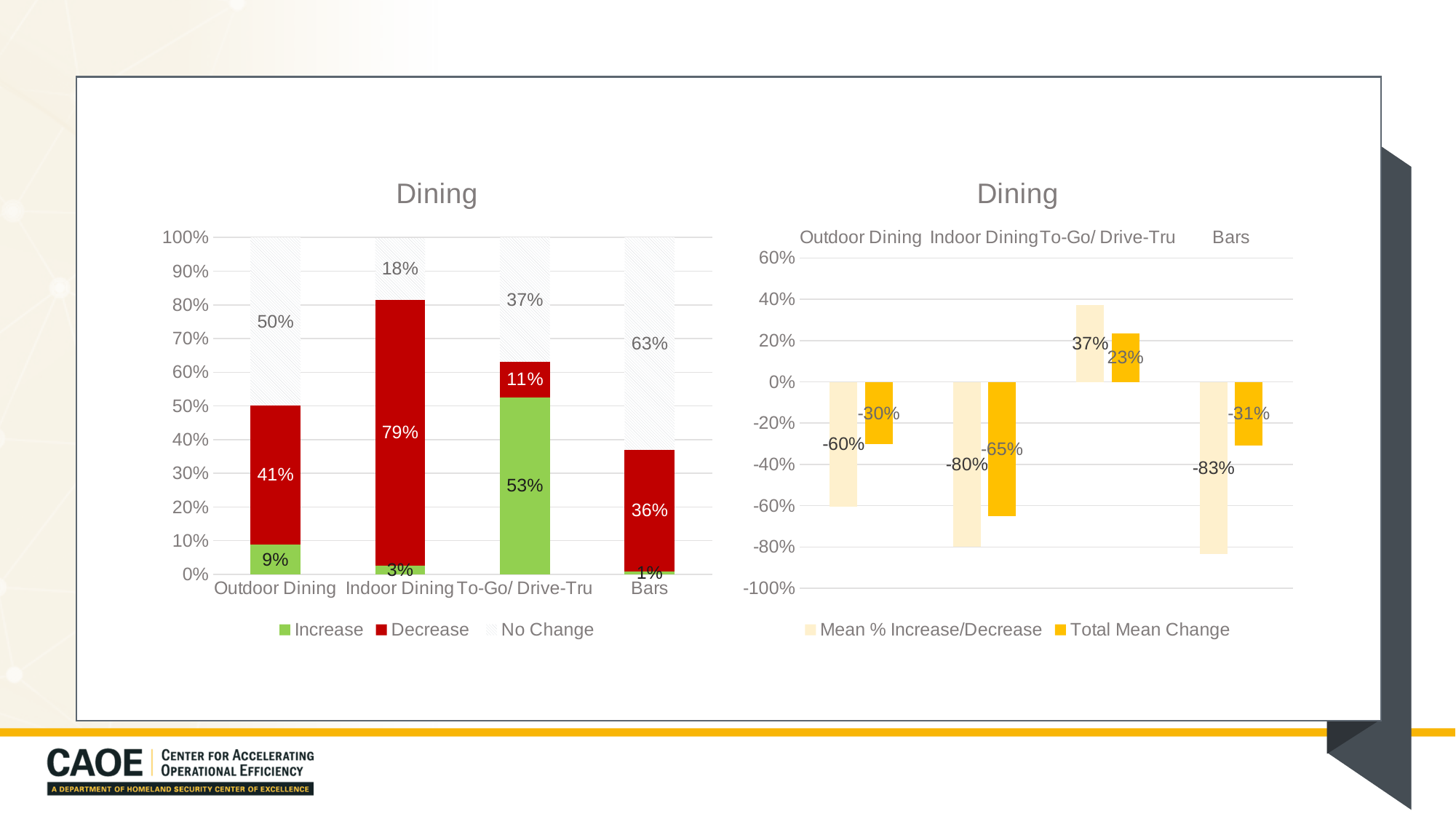
In the right chart, what is the Total Mean Change for Indoor Dining? -65% What kind of chart is the left chart? Stacked bar chart In the left chart, what is the Increase value for To-Go/ Drive-Tru? 53% In the right chart, which category is the only one with a positive Total Mean Change? To-Go/ Drive-Tru In the left chart, what is the difference between the Decrease values for Outdoor Dining and Bars? 5% In the left chart, which category has the highest Decrease value? Indoor Dining In the left chart, what percentage of Indoor Dining respondents reported a Decrease? 79% In the right chart, what is the Mean % Increase/Decrease for Bars? -83% In the left chart, what is the No Change value for Bars? 63% In the left chart, which category has the lowest Increase value? Bars In the left chart, how many series does the legend list? 3 In the right chart, which is larger in magnitude: the Mean % Increase/Decrease for Outdoor Dining or for Indoor Dining? Indoor Dining